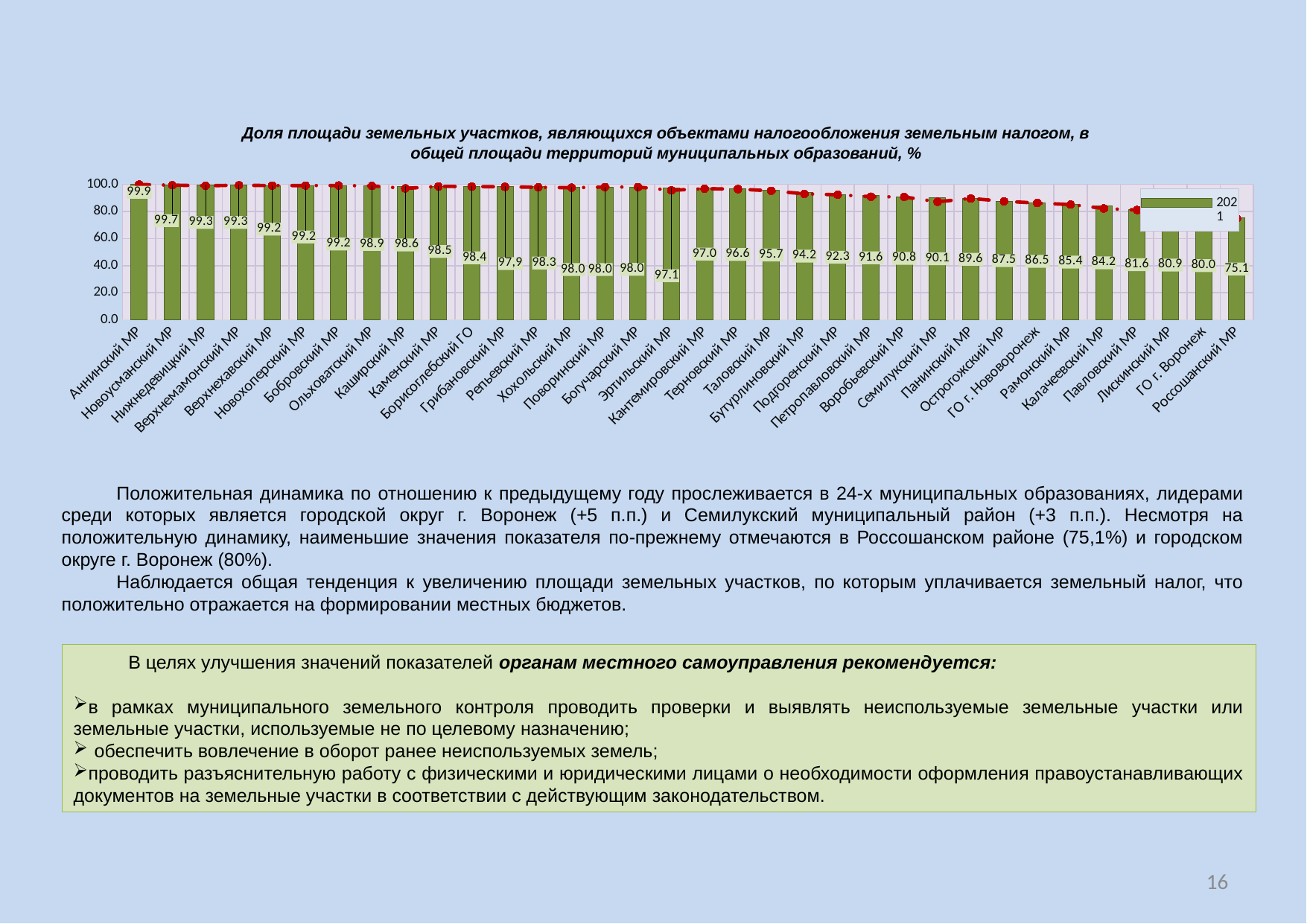
What kind of chart is this? combination bar and line chart What is the value for Россошанский МР? 75.1 What is the difference between the values for Аннинский МР and Россошанский МР? 24.8 What is the value for ГО г. Воронеж? 80.0 Which is larger, the value for Таловский МР or the value for Бутурлиновский МР? Таловский МР Is the value for Павловский МР greater or less than 80.0? greater Which municipality has the highest value? Аннинский МР What is the value for Семилукский МР? 90.1 How many municipalities are shown on the chart? 34 What is the value for Кантемировский МР? 97.0 Which municipality has the lowest value? Россошанский МР Do the values rise or fall from left to right along the x axis? fall